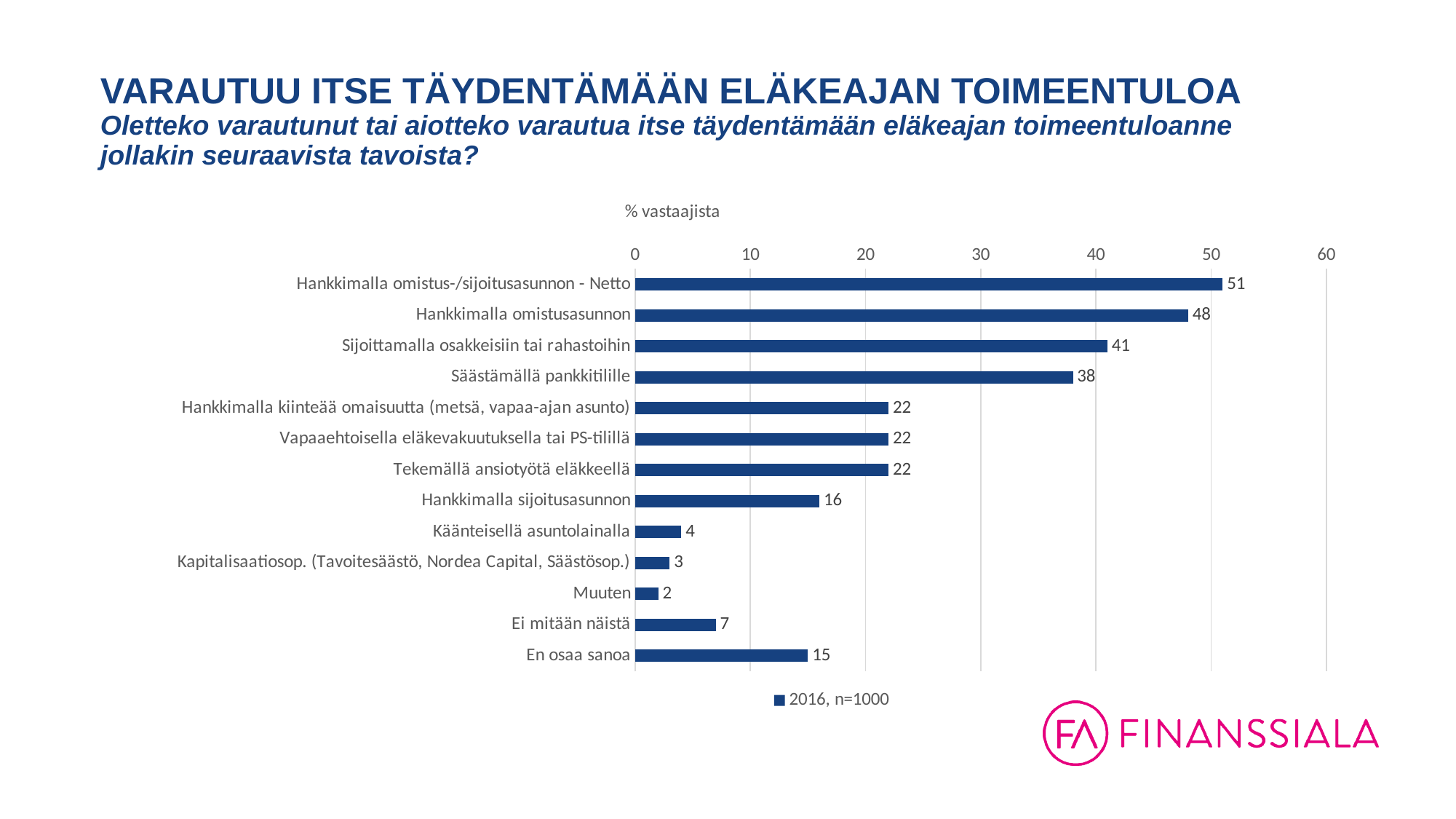
How many series does the legend list? 1 What is the value for "En osaa sanoa"? 15 What is the value for "Hankkimalla omistusasunnon"? 48 What is the difference between "Sijoittamalla osakkeisiin tai rahastoihin" and "Hankkimalla sijoitusasunnon"? 25 Which category has the lowest value? Muuten What kind of chart is shown on the slide? Bar chart What is the value for "Säästämällä pankkitilille"? 38 How many categories are shown in the chart? 13 Which category has the highest value? Hankkimalla omistus-/sijoitusasunnon - Netto Is the value for "Hankkimalla omistus-/sijoitusasunnon - Netto" greater or less than 50? greater What is the legend entry of the chart? 2016, n=1000 Which is larger, "Ei mitään näistä" or "Käänteisellä asuntolainalla"? Ei mitään näistä